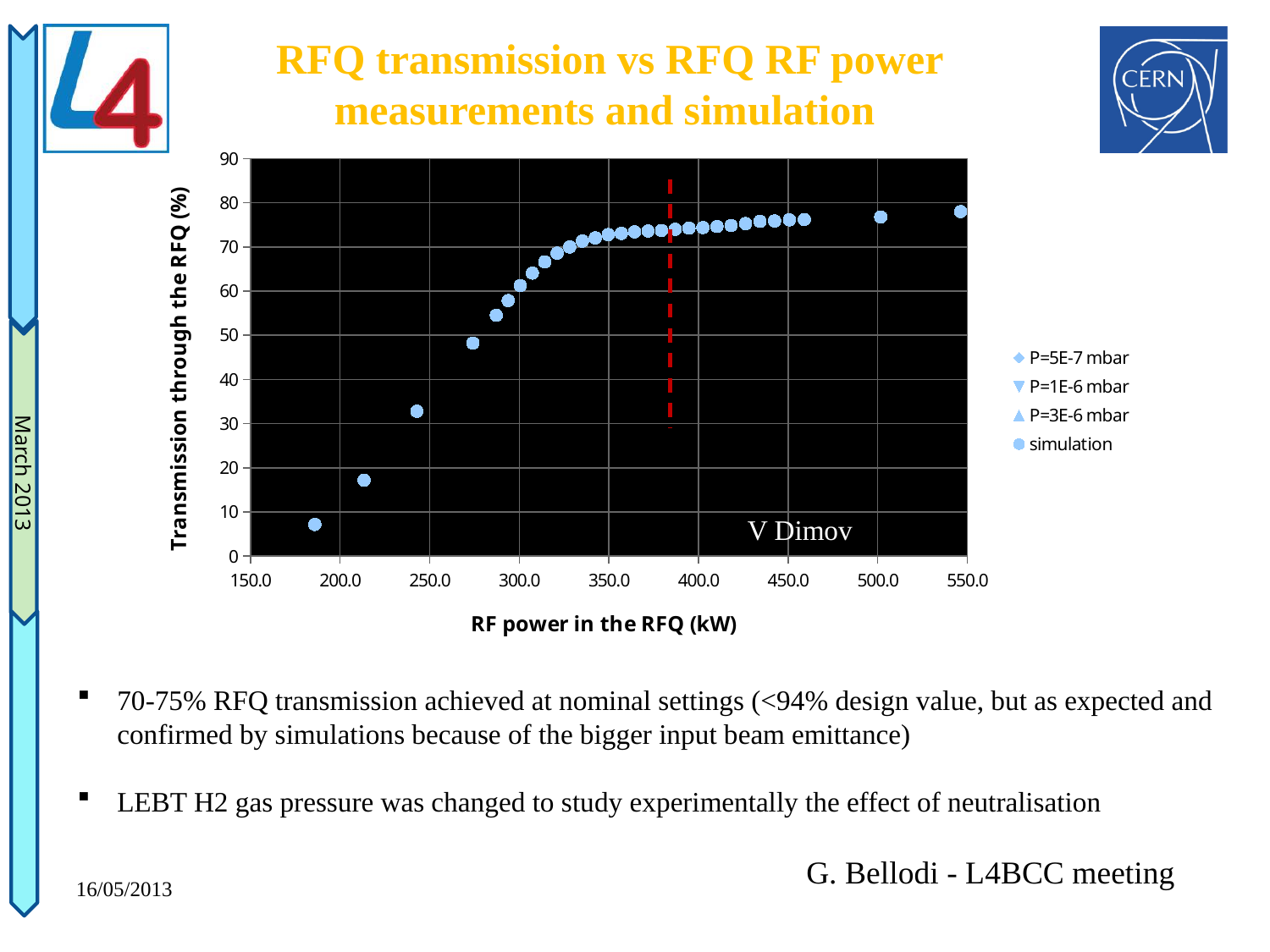
Does the simulation transmission rise or fall as RF power increases along the x axis? rise Is the simulation transmission value at about 250 kW RF power greater or less than 50? less What is the label of the x axis of the chart? RF power in the RFQ (kW) Is the simulation transmission value at about 400 kW RF power greater or less than 60? greater How many series does the chart legend list? 4 Is the simulation transmission value at the highest plotted RF power (near 550 kW) greater or less than 70? greater Which has the higher simulation transmission: the point near 300 kW or the point near 500 kW? the point near 500 kW What is the maximum value shown on the y axis of the chart? 90 What kind of chart is shown on the slide? scatter chart What is the title of the chart on the slide? RFQ transmission vs RFQ RF power measurements and simulation